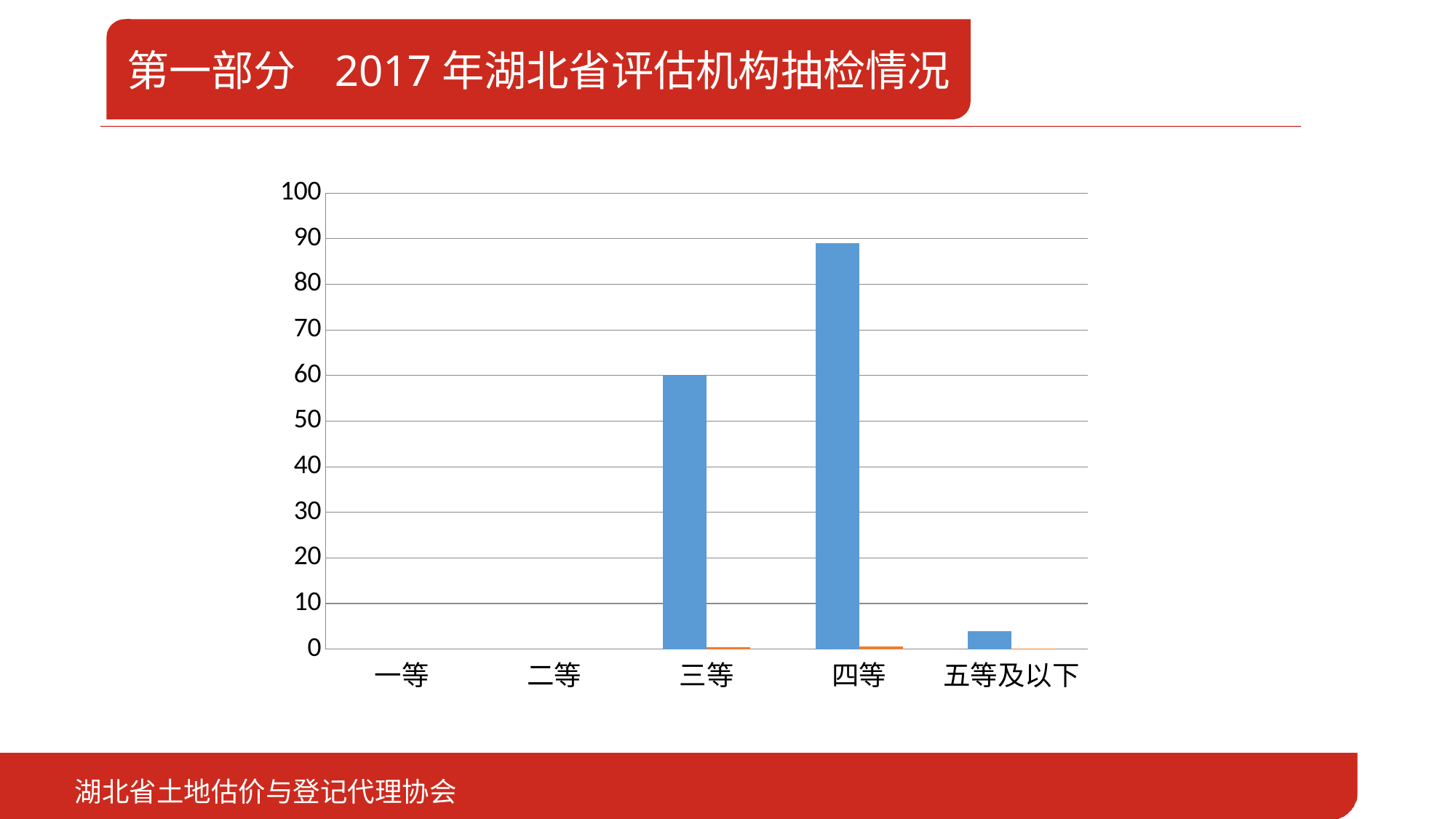
What kind of chart is shown on the slide? bar chart Which has the larger blue bar, 三等 or 四等? 四等 Which categories show no visible bar at all in the chart? 一等 and 二等 Is the value of the blue bar for 四等 greater or less than 80? greater What colour are the tall bars for 三等 and 四等? blue How many categories are shown on the x axis of the chart? 5 What is the highest value shown on the vertical axis of the chart? 100 Is the value of the blue bar for 五等及以下 greater or less than 10? less Is the value of the blue bar for 三等 greater or less than 50? greater Which category has the tallest blue bar in the chart? 四等 What is the value of the blue bar for 三等? 60 Which has the larger blue bar, 五等及以下 or 三等? 三等